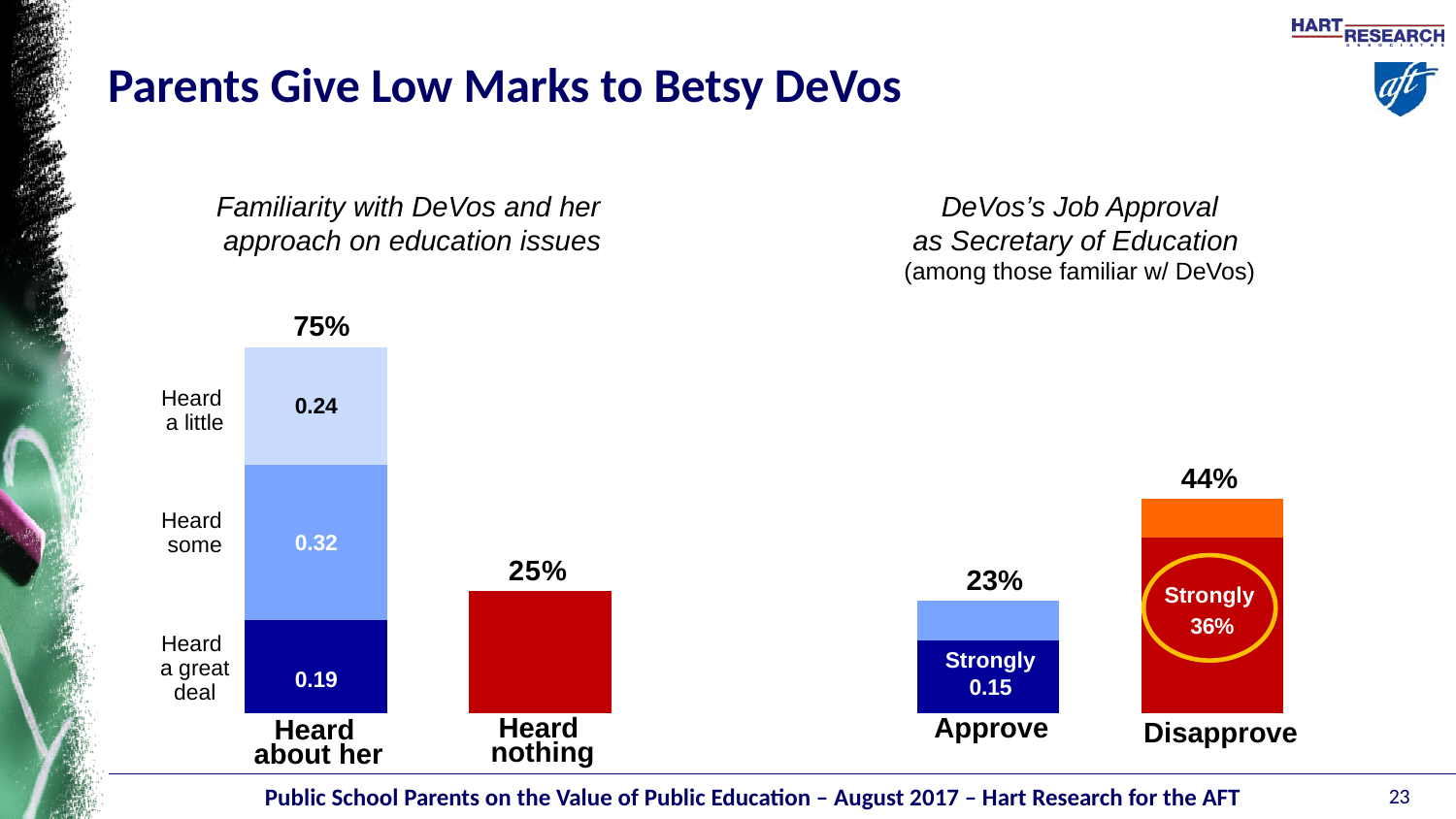
In the 'DeVos's Job Approval' chart, what is the 'Strongly' approve value? 0.15 What kind of chart is used on the right side of the slide for DeVos's Job Approval? Bar chart In the 'Familiarity with DeVos' chart, what is the value of the 'Heard a little' segment? 0.24 In the 'DeVos's Job Approval' chart, what is the difference between the Disapprove and Approve percentages? 21% In the 'Familiarity with DeVos' chart, what is the value of the 'Heard some' segment? 0.32 In the 'DeVos's Job Approval' chart, what percentage of parents approve? 23% In the 'Familiarity with DeVos' chart, which segment of the 'Heard about her' bar is the largest? Heard some In the 'Familiarity with DeVos' chart, what is the value of the 'Heard a great deal' segment? 0.19 In the 'DeVos's Job Approval' chart, what percentage of parents disapprove? 44% In the 'Familiarity with DeVos' chart, what value is shown for 'Heard nothing'? 25% In the 'DeVos's Job Approval' chart, what is the 'Strongly' disapprove value? 36% In the 'Familiarity with DeVos' chart, what is the total value shown above the 'Heard about her' bar? 75%